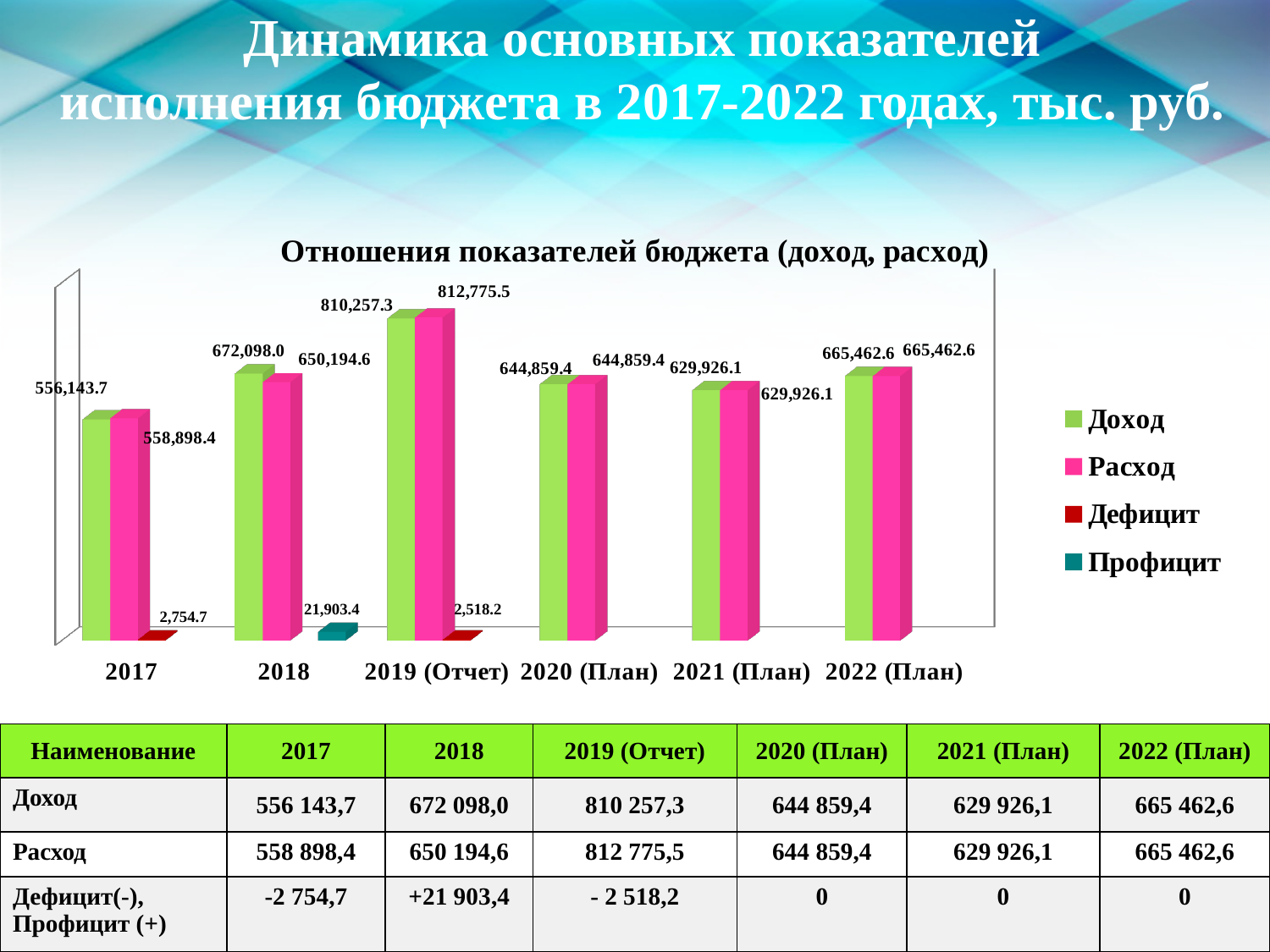
In 2018, which is larger: Доход or Расход? Доход What kind of chart is shown on the slide? Bar chart Does Доход rise or fall from 2019 (Отчет) to 2021 (План)? Fall What is the difference between Доход and Расход in 2018? 21,903.4 How many series does the legend list? 4 What is the value of Расход for 2019 (Отчет)? 812,775.5 In which year is Доход the lowest? 2017 What is the difference between Расход and Доход in 2019 (Отчет)? 2,518.2 In which year is Доход the highest? 2019 (Отчет) What is the value of Профицит shown for 2018? 21,903.4 How many year categories are shown on the x axis? 6 What is the value of Доход for 2017? 556,143.7